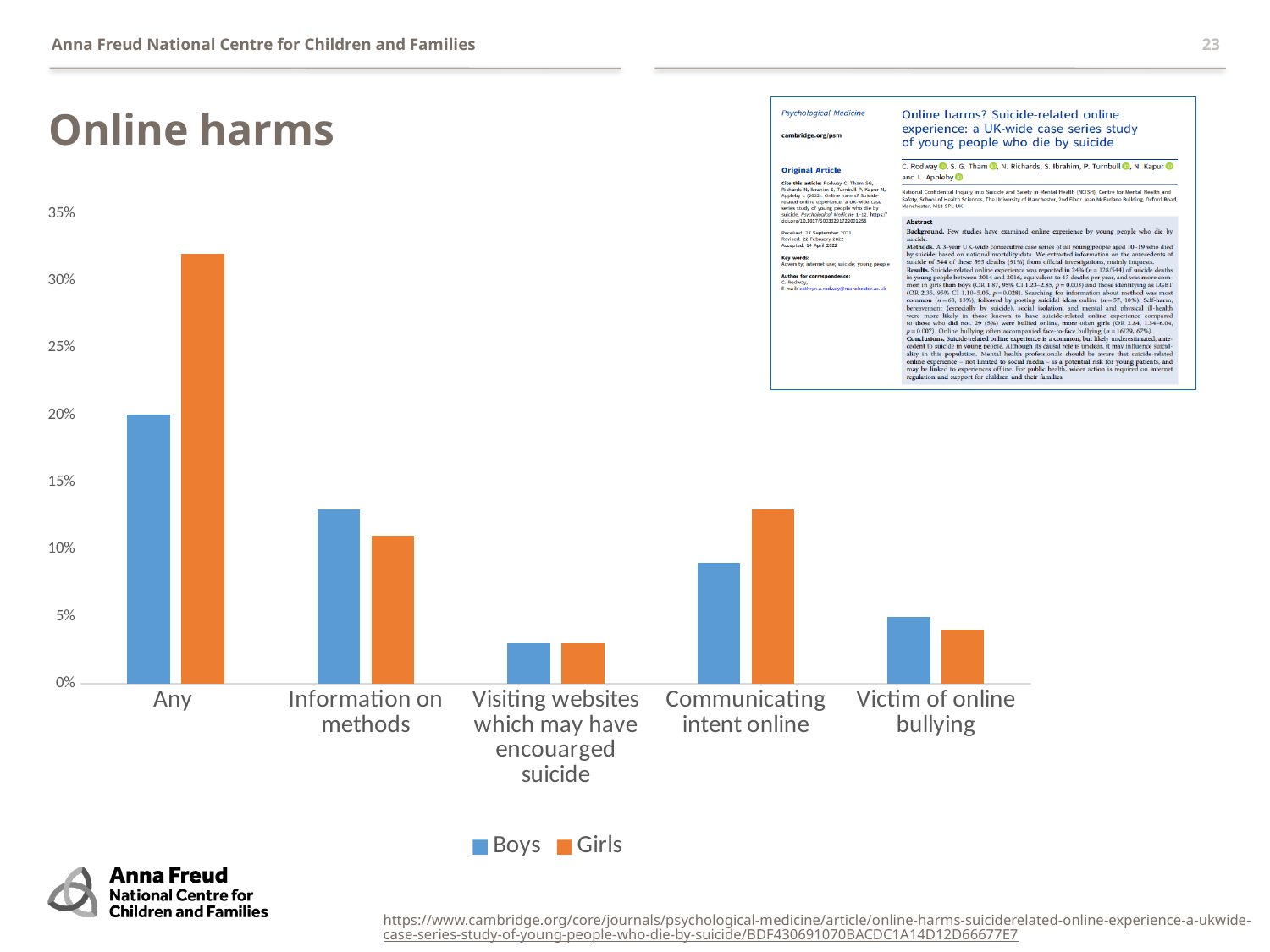
Is the value for Boys in the Communicating intent online category greater or less than 10%? less Is the value for Girls in the Any category greater or less than 30%? greater Is the value for Girls in the Communicating intent online category greater or less than 10%? greater Which category has the lowest value for Boys? Visiting websites which may have encouarged suicide What are the two legend entries of the chart? Boys and Girls Which category has the highest value for Girls? Any How many categories are shown on the x axis? 5 In the Information on methods category, which is larger, Boys or Girls? Boys What is the value for Boys in the Victim of online bullying category? 5% What is the value for Boys in the Any category? 20% How many series does the legend list? 2 What kind of chart is shown on the slide? bar chart